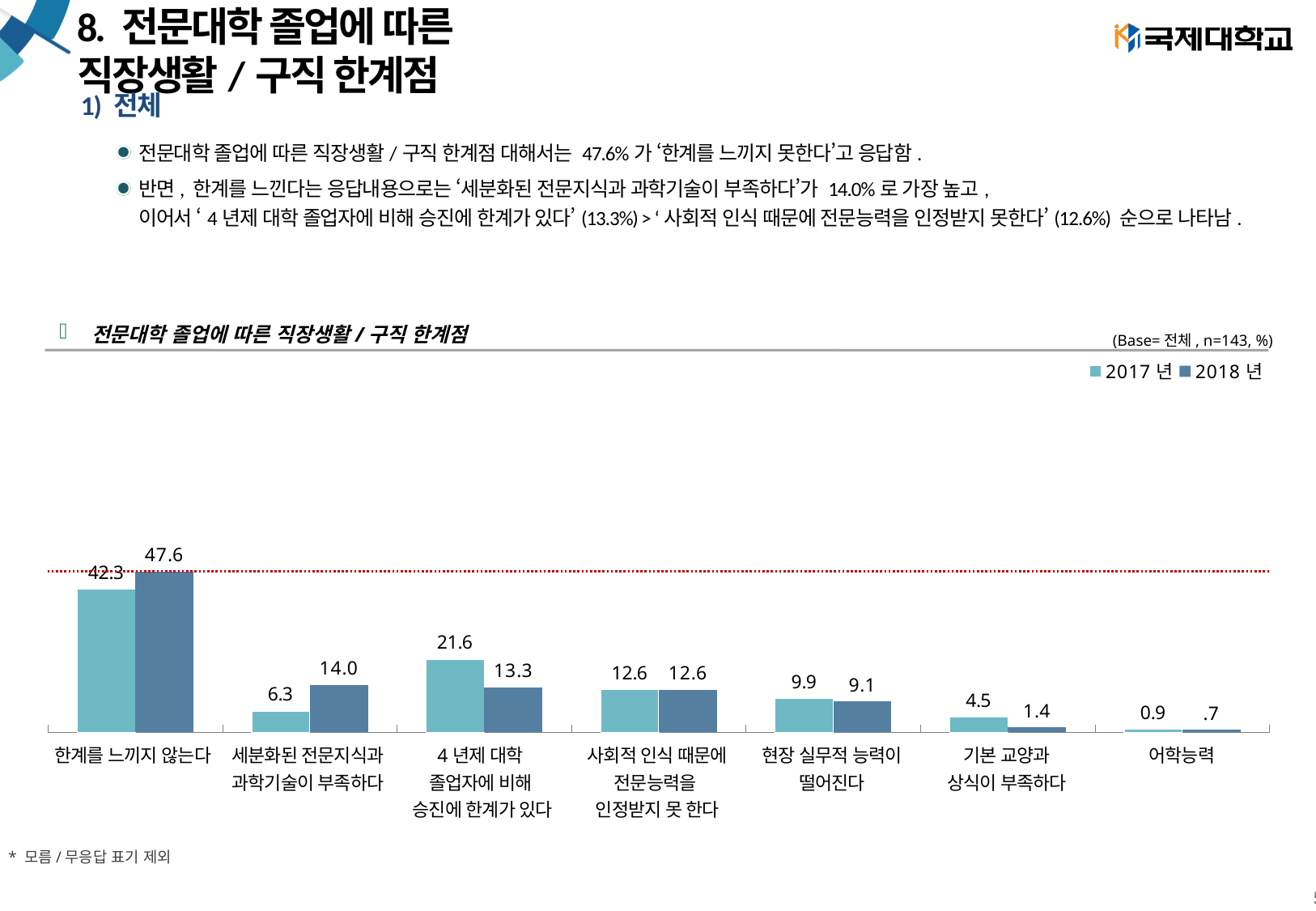
What is the 2018년 value for '세분화된 전문지식과 과학기술이 부족하다'? 14.0 How many categories are shown on the x axis of the chart? 7 How many series does the chart legend list? 2 What is the 2018년 value for '한계를 느끼지 않는다'? 47.6 What is the difference between the 2017년 and 2018년 values for '4 년제 대학 졸업자에 비해 승진에 한계가 있다'? 8.3 For '기본 교양과 상식이 부족하다', which year has the larger value, 2017년 or 2018년? 2017년 What is the 2017년 value for '4 년제 대학 졸업자에 비해 승진에 한계가 있다'? 21.6 What is the difference between the 2018년 and 2017년 values for '한계를 느끼지 않는다'? 5.3 What kind of chart is shown on the slide? Bar chart Which category has the lowest 2017년 value? 어학능력 Which category has the highest 2018년 value? 한계를 느끼지 않는다 For '세분화된 전문지식과 과학기술이 부족하다', which year has the larger value, 2017년 or 2018년? 2018년